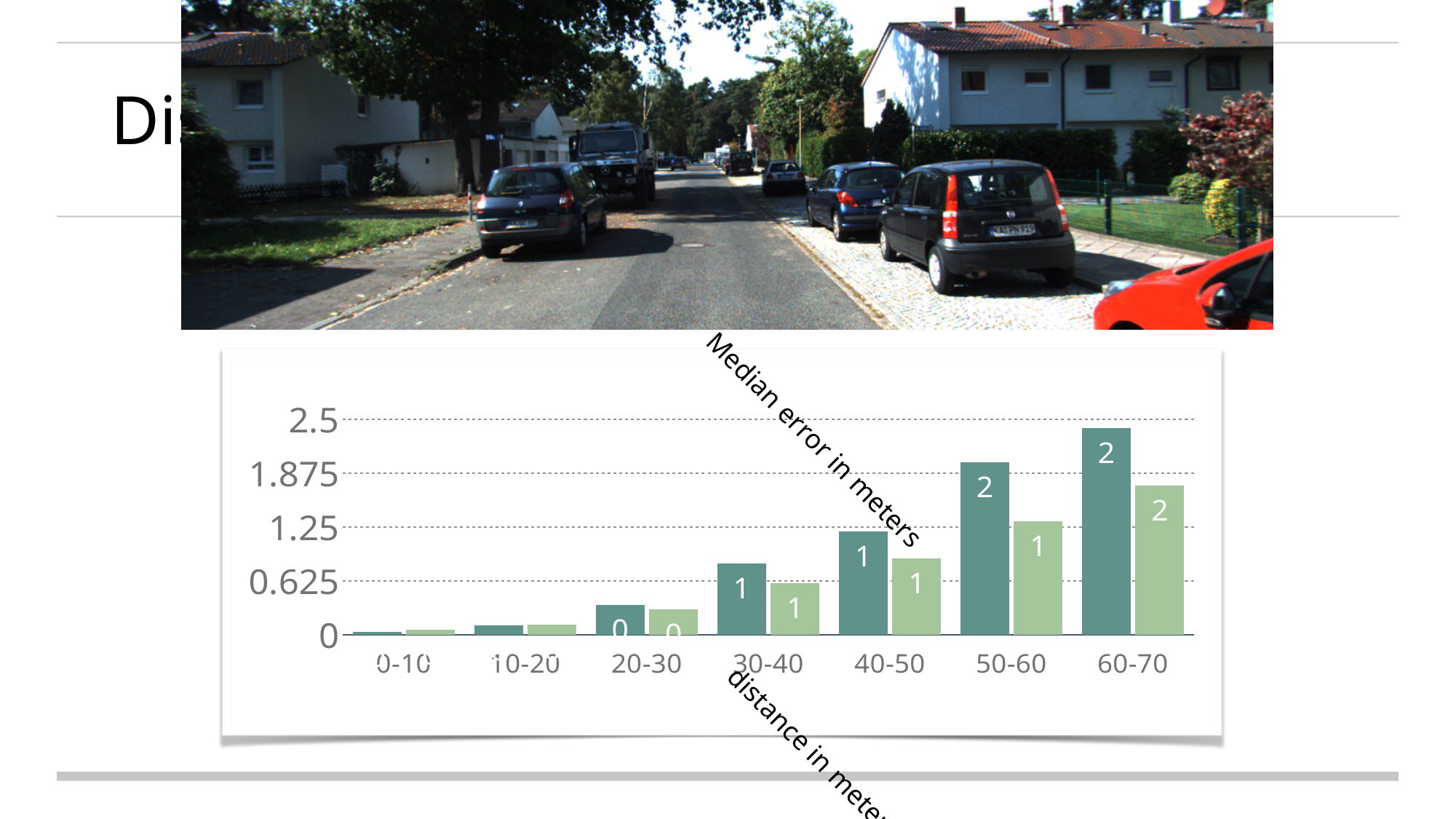
What data label is printed on the light green bar for the 40-50 category? 1 What data label is printed on the dark teal bar for the 60-70 category? 2 Do the bar values rise or fall as distance increases along the x axis? rise Is the dark teal bar for the 60-70 category greater or less than 1.875? greater What kind of chart is shown on the slide? bar chart How many distance categories are shown on the x axis of the chart? 7 Which distance category has the shortest bars in the chart? 0-10 Is the dark teal bar for the 20-30 category greater or less than 0.625? less In the 60-70 category, which bar is taller, the dark teal bar or the light green bar? the dark teal bar What is the title of the vertical axis of the chart? Median error in meters What data label is printed on the dark teal bar for the 20-30 category? 0 Which distance category has the tallest bar in the chart? 60-70